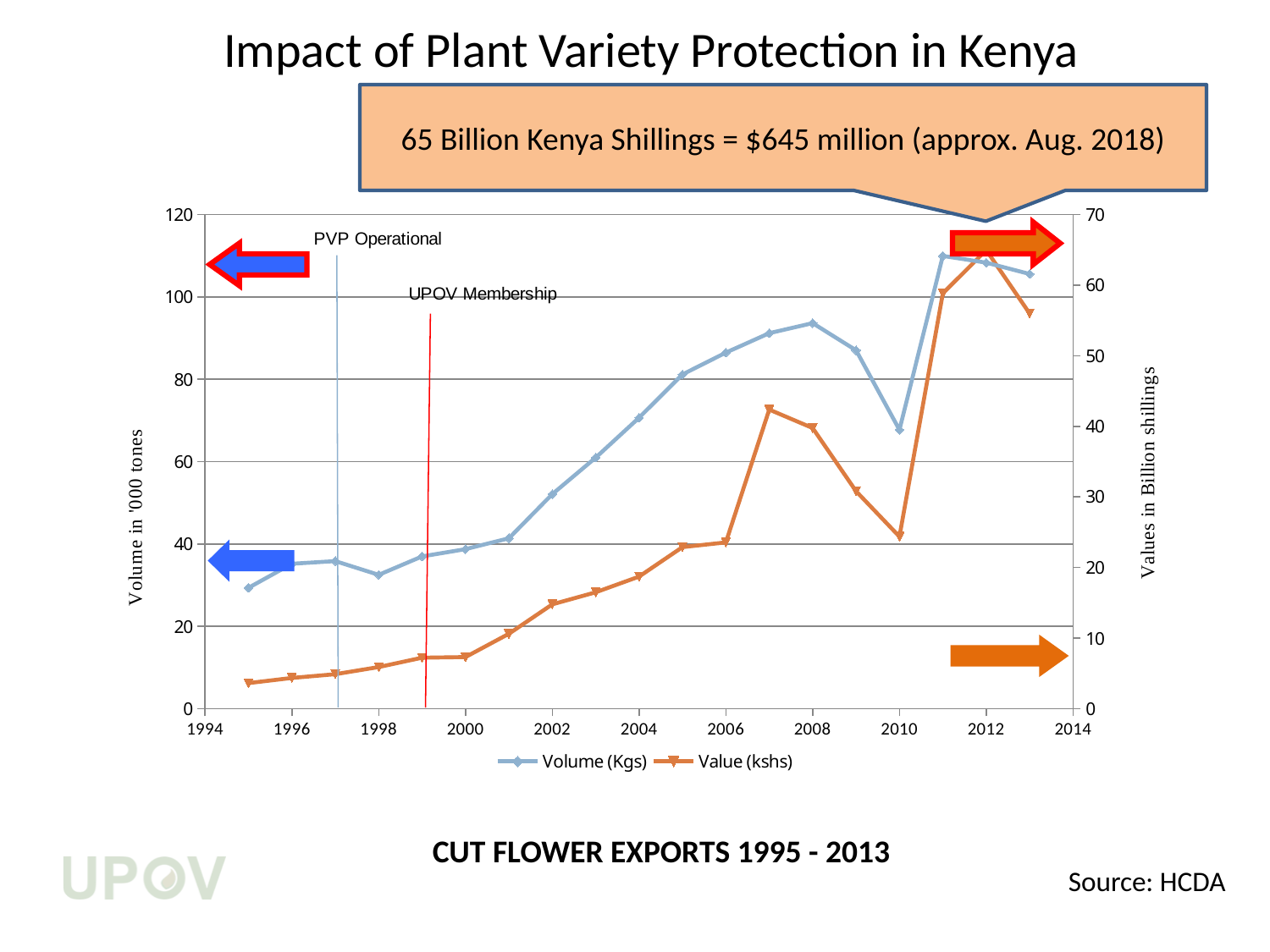
How many yearly data points does each series in the chart have? 19 Does the Volume (Kgs) series rise or fall between 2001 and 2008? rise In which year is the Value (kshs) series at its highest? 2012 Which year has the larger Volume (Kgs) value, 2008 or 2010? 2008 Is the Volume (Kgs) value for 2008 greater or less than 80? greater Is the Volume (Kgs) value for 2010 greater or less than 80? less What are the two series named in the chart legend? Volume (Kgs) and Value (kshs) In which year is the Value (kshs) series at its lowest? 1995 How many series does the chart legend list? 2 What kind of chart is shown on the slide? line chart Is the Value (kshs) figure for 2010 greater or less than 30? less What is the title of the right-hand vertical axis of the chart? Values in Billion shillings